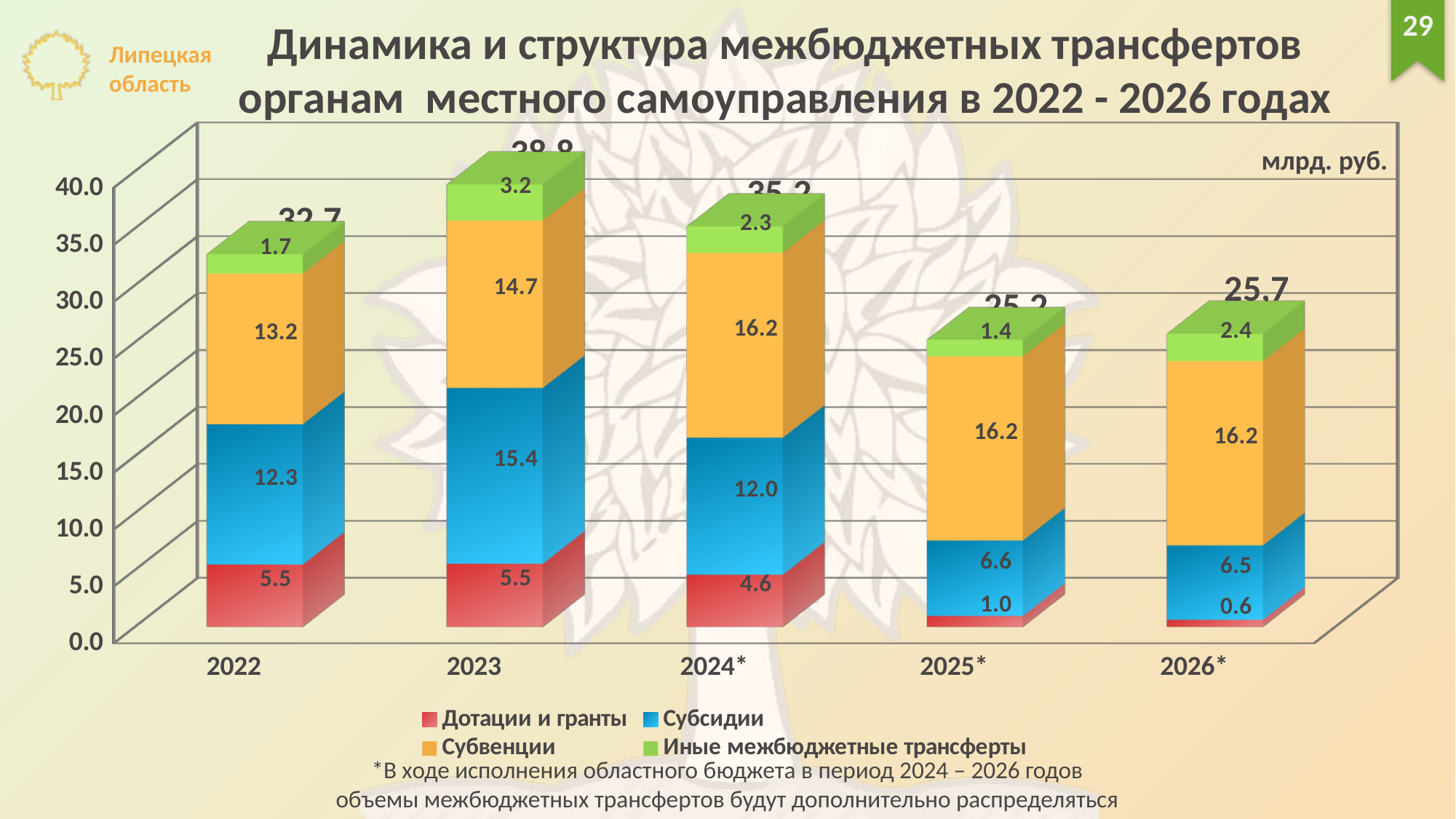
Which is larger: Иные межбюджетные трансферты in 2023 or in 2026*? 2023 How many years are shown on the x axis? 5 What is the value of Субвенции for 2023? 14.7 What is the difference between the Субсидии values for 2023 and 2025*? 8.8 What is the total of the stacked bar for 2026*? 25.7 How many series does the legend list? 4 Do the Дотации и гранты values rise or fall from 2022 to 2026*? Fall What kind of chart is shown on the slide? Stacked bar chart In which year is the Субсидии segment the largest? 2023 What is the value of Субсидии for 2024*? 12.0 In which year is the Дотации и гранты segment the smallest? 2026* What is the value of Дотации и гранты for 2026*? 0.6